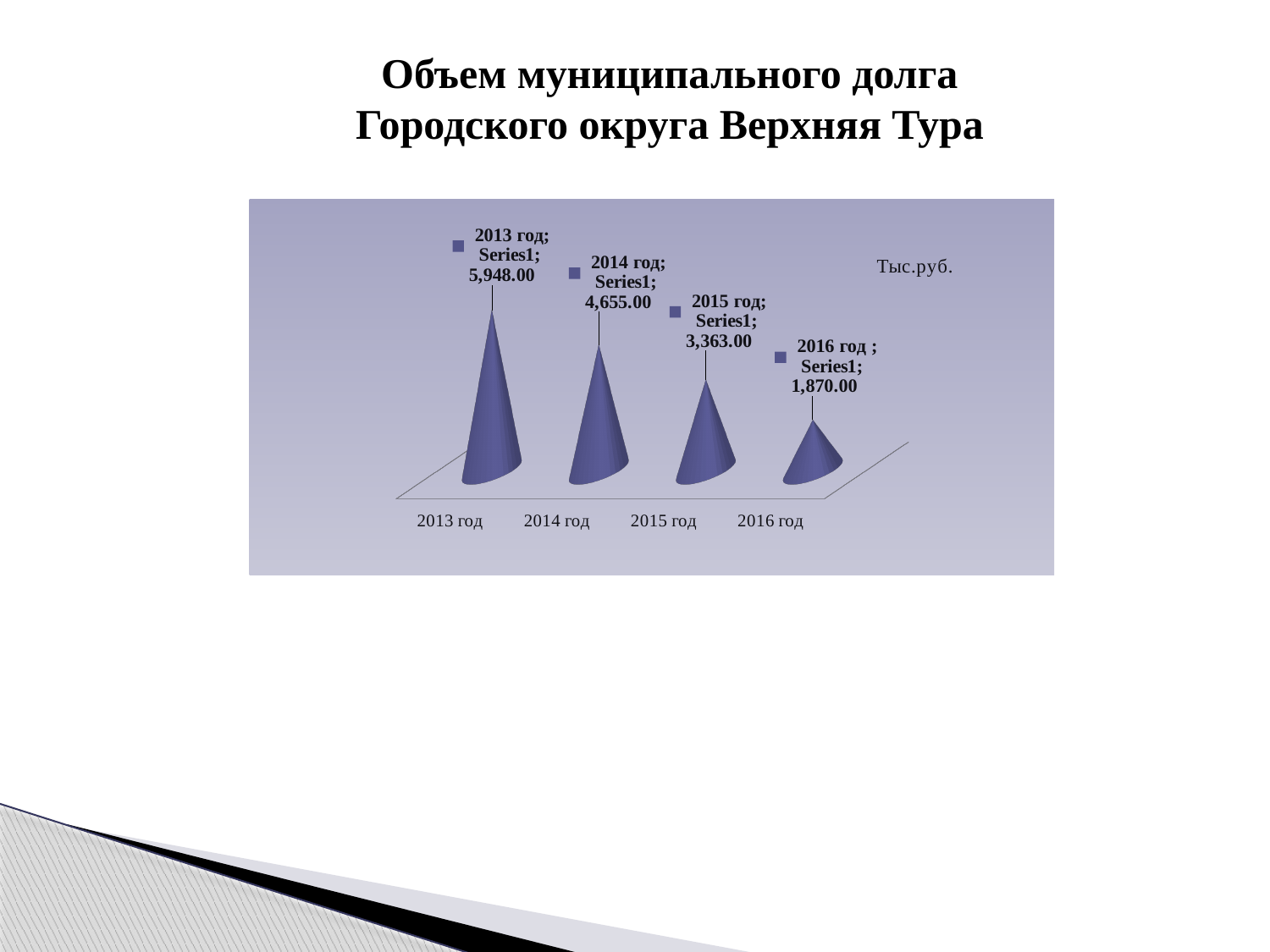
Which year has the lowest value? 2016 год What is the difference between the values for 2013 год and 2016 год? 4,078.00 Which year has the highest value? 2013 год What is the value for 2014 год? 4,655.00 How many years are shown on the chart? 4 Do the values rise or fall from 2013 год to 2016 год? fall What is the value for 2013 год? 5,948.00 What is the value for 2016 год? 1,870.00 What is the difference between the values for 2013 год and 2014 год? 1,293.00 What unit is indicated on the chart? Тыс.руб. Which is larger, the value for 2014 год or the value for 2015 год? 2014 год What is the value for 2015 год? 3,363.00